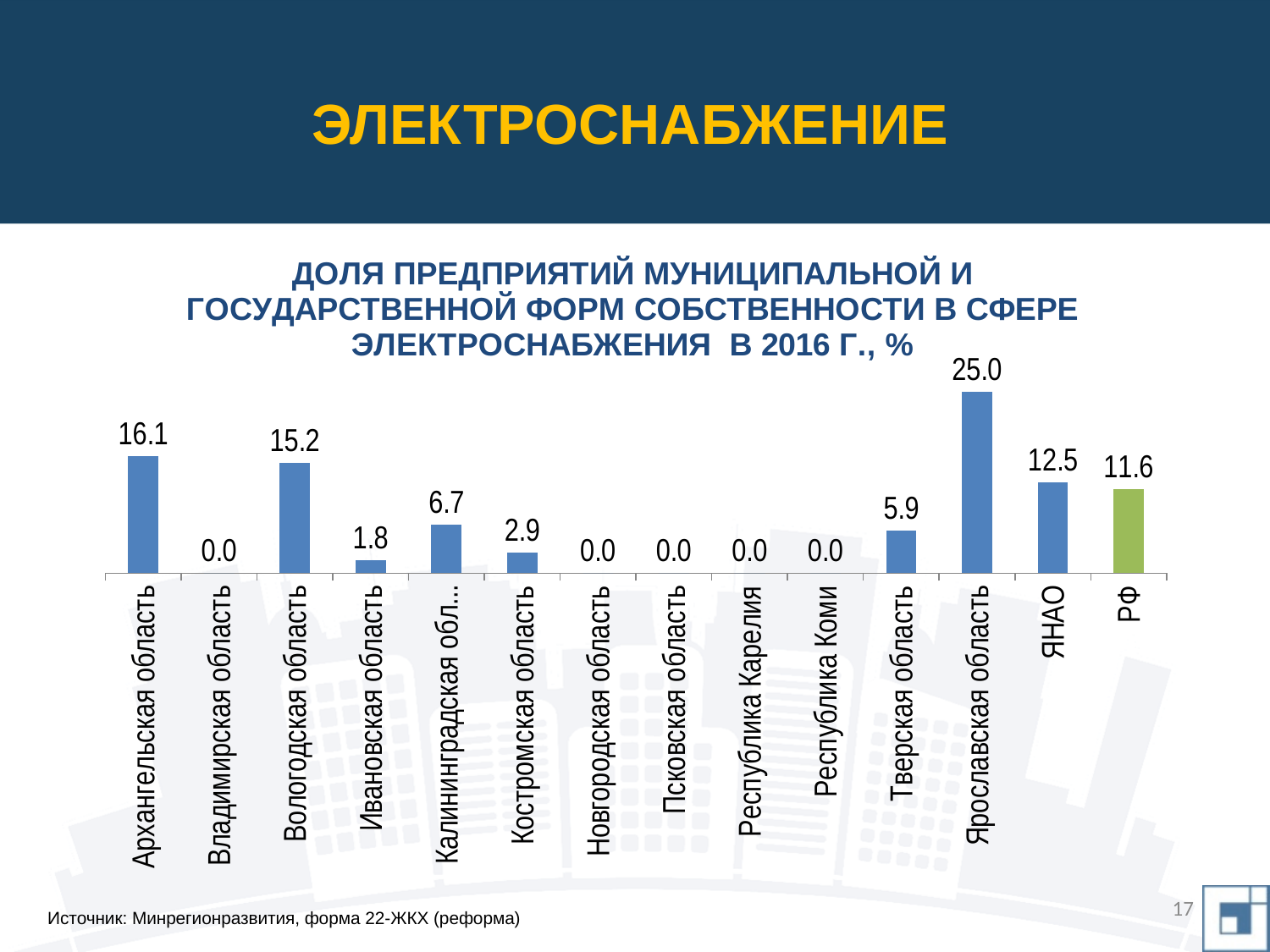
What is the value for РФ? 11.6 What is the value for Ярославская область? 25.0 What is the difference between the values for Ярославская область and ЯНАО? 12.5 What kind of chart is shown on the slide? Bar chart What is the value for Архангельская область? 16.1 How many categories are shown on the x axis? 14 How many categories have a value of 0.0? 5 What is the value for Тверская область? 5.9 Which is larger, the value for Калининградская обл... or the value for Костромская область? Калининградская обл... Which category has the highest value? Ярославская область Which is larger, the value for ЯНАО or the value for РФ? ЯНАО What is the difference between the values for Архангельская область and Вологодская область? 0.9